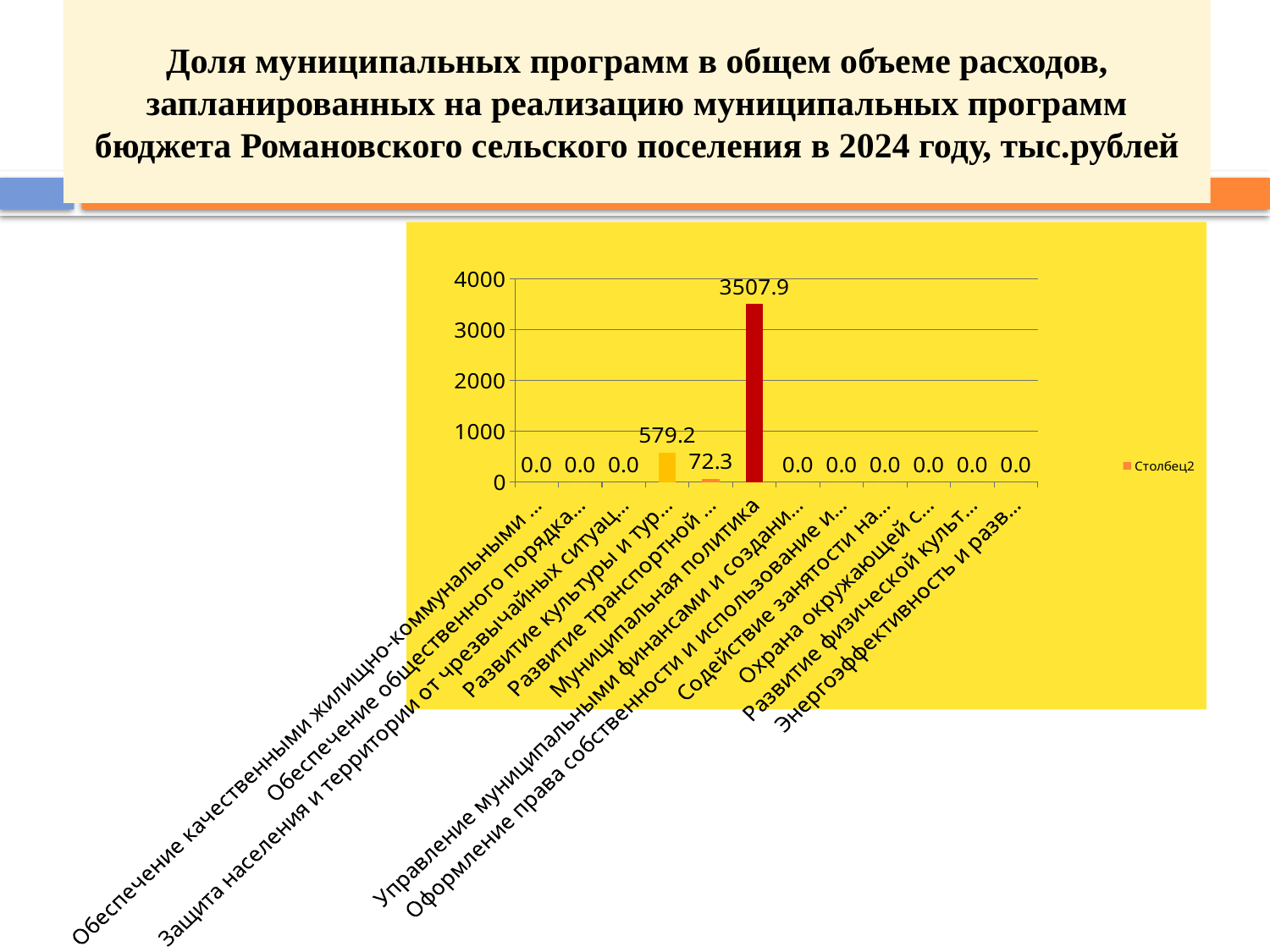
What kind of chart is shown on the slide? bar chart What is the value for the category "Муниципальная политика"? 3507.9 What is the value for the category labelled "Развитие культуры и тур..."? 579.2 How many categories are shown on the x axis? 12 Which is larger: the value for "Развитие культуры и тур..." or the value for "Развитие транспортной ..."? Развитие культуры и тур... Is the value for "Муниципальная политика" greater or less than 3000? greater What is the difference between the values for "Развитие культуры и тур..." and "Развитие транспортной ..."? 506.9 What is the value for the category labelled "Развитие транспортной ..."? 72.3 How many categories have a value of 0.0? 9 Which category has the highest value? Муниципальная политика How many series does the legend list? 1 What is the difference between the values for "Муниципальная политика" and "Развитие культуры и тур..."? 2928.7